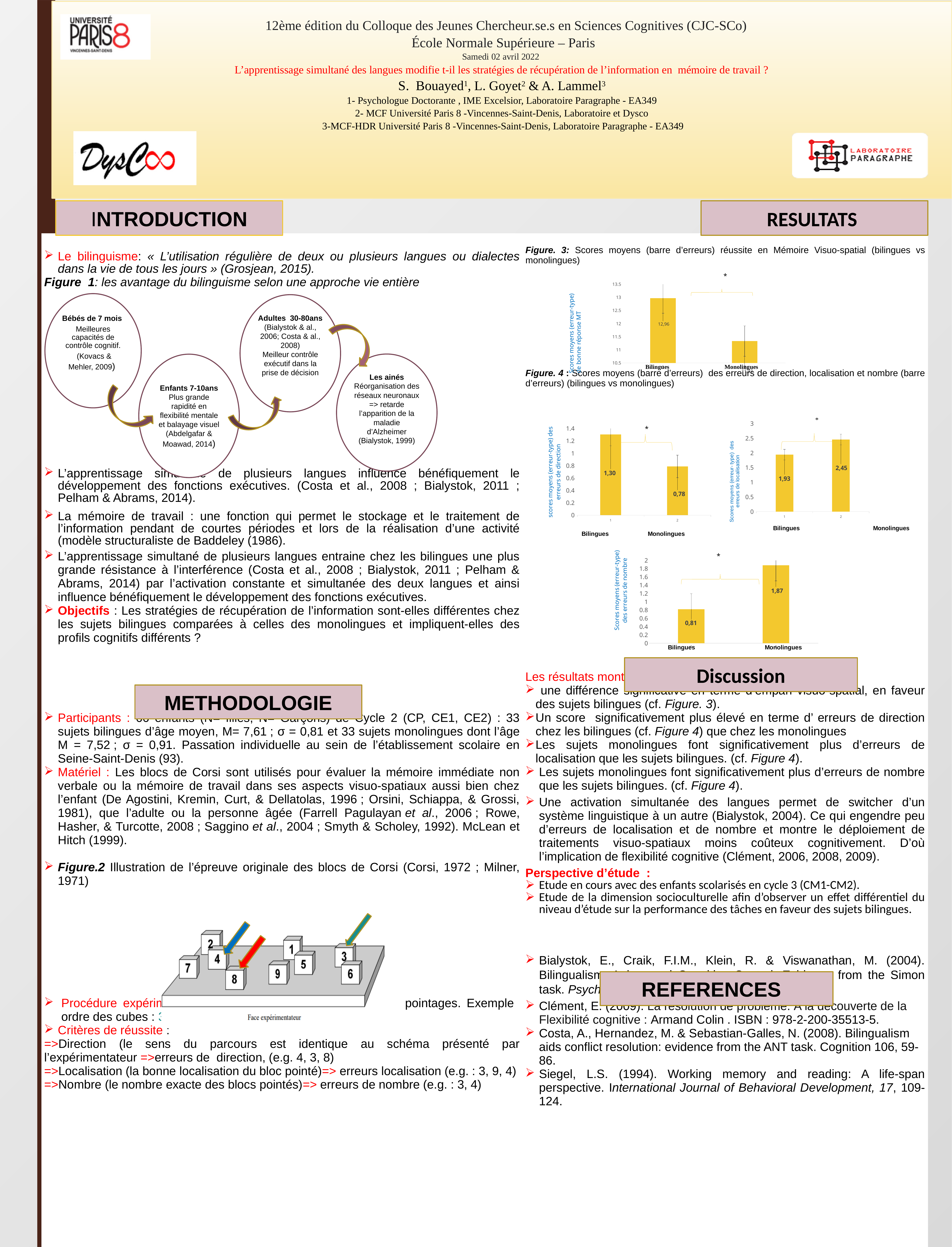
In Figure 3 (scores moyens réussite en Mémoire Visuo-spatial), is the value for Monolingues greater or less than 12? less In Figure 3 (scores moyens réussite en Mémoire Visuo-spatial), what is the value for Bilingues? 12,96 In the Figure 4 chart of erreurs de nombre, what is the value for Bilingues? 0,81 How many categories are shown in the Figure 4 chart of erreurs de nombre? 2 In the Figure 4 chart of erreurs de direction, what is the value for Bilingues? 1,30 In the Figure 4 chart of erreurs de nombre, what is the difference between the Monolingues and Bilingues values? 1,06 In the Figure 4 chart of erreurs de direction, what is the difference between the Bilingues and Monolingues values? 0,52 In the Figure 4 chart of erreurs de localisation, what is the value for Monolingues? 2,45 In Figure 3 (scores moyens réussite en Mémoire Visuo-spatial), which group has the higher bar, Bilingues or Monolingues? Bilingues In the Figure 4 chart of erreurs de direction, what is the value for Monolingues? 0,78 In the Figure 4 chart of erreurs de localisation, which group has the lowest value? Bilingues What kind of chart is Figure 3 (scores moyens réussite en Mémoire Visuo-spatial)? bar chart